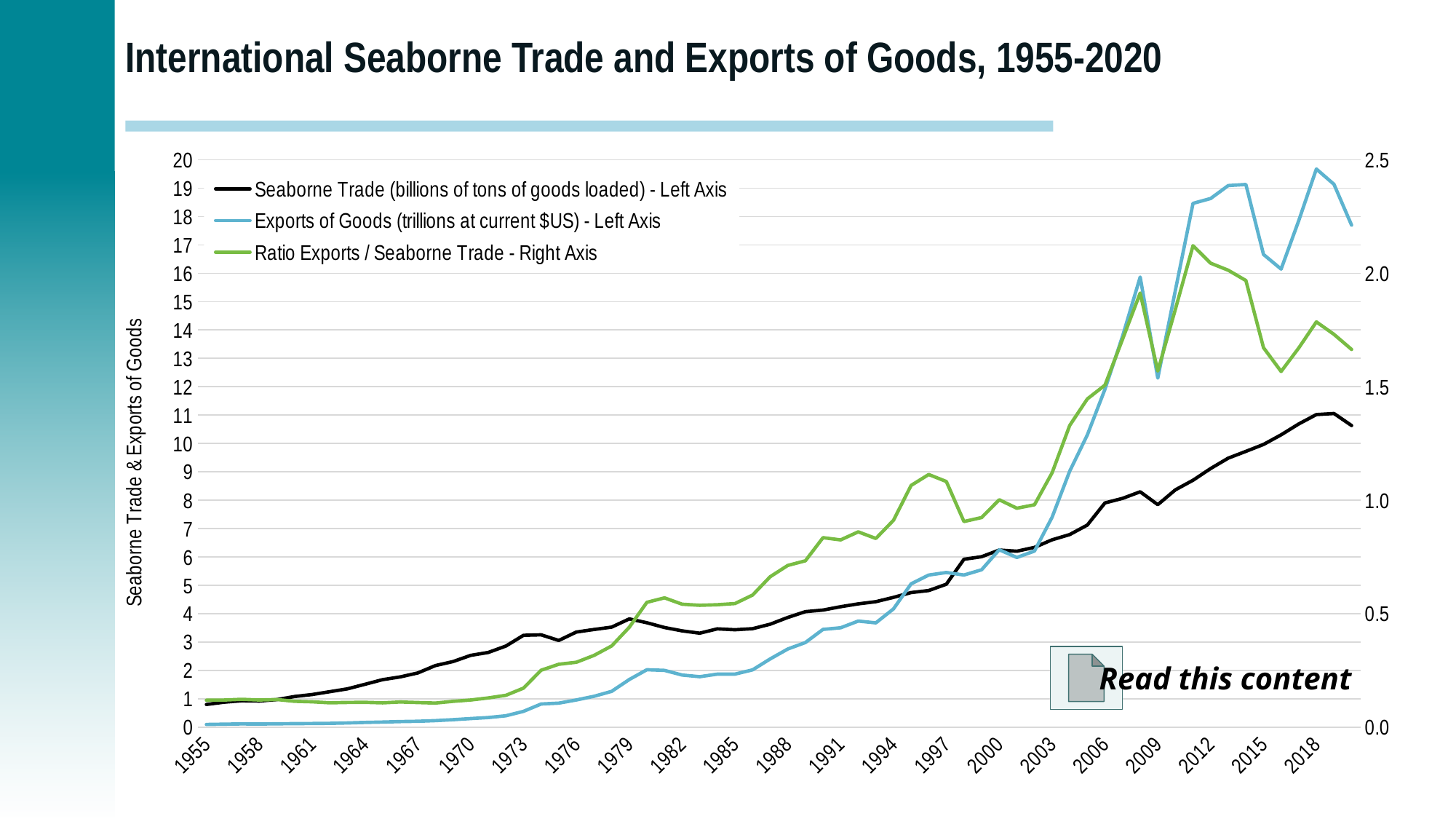
Is the value for Exports of Goods in 2009 greater or less than 14? less Does Seaborne Trade rise or fall overall from 1955 to 2020? Rise Is the value for Seaborne Trade in 2012 greater or less than 8? greater Is the value for Seaborne Trade in 1955 greater or less than 2? less How many series does the legend list? 3 What is the title of the chart? International Seaborne Trade and Exports of Goods, 1955-2020 Does Exports of Goods rise or fall overall from 1955 to 2018? Rise In 2018, which is larger: Seaborne Trade or Exports of Goods? Exports of Goods Which series is plotted against the right axis? Ratio Exports / Seaborne Trade What kind of chart is shown on the slide? Line chart In 1979, which is larger: Seaborne Trade or Exports of Goods? Seaborne Trade